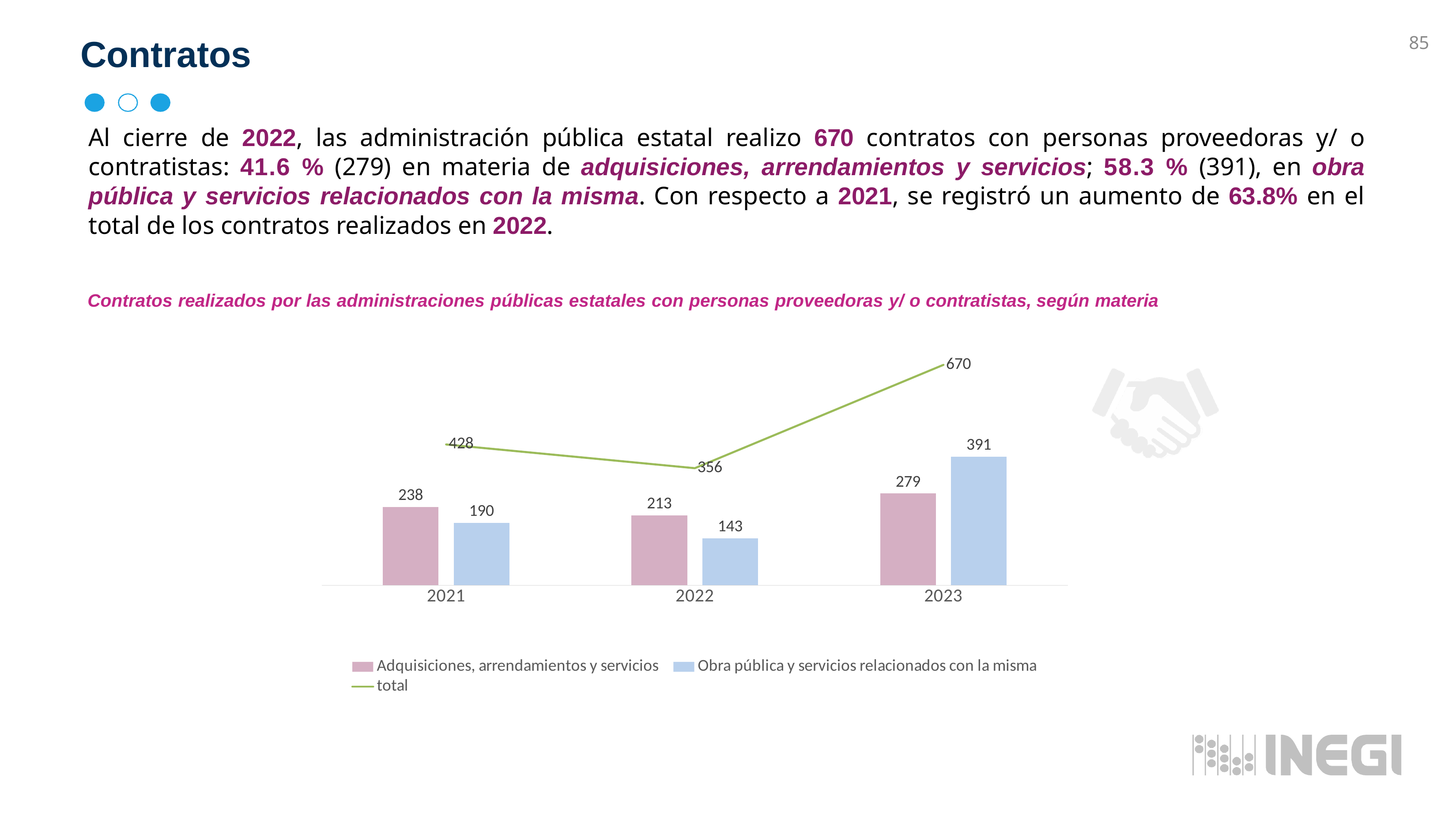
Does the total rise or fall from 2021 to 2022? Fall What is the value for Adquisiciones, arrendamientos y servicios in 2021? 238 How many years are shown on the x axis? 3 What is the difference between the total for 2023 and the total for 2022? 314 Which series is drawn as a line? total How many series does the legend list? 3 What is the value for Obra pública y servicios relacionados con la misma in 2022? 143 In which year is the total highest? 2023 What is the total value shown for 2023? 670 In which year is the value for Obra pública y servicios relacionados con la misma lowest? 2022 What kind of chart is this? Combined bar and line chart Which is larger in 2023: Adquisiciones, arrendamientos y servicios or Obra pública y servicios relacionados con la misma? Obra pública y servicios relacionados con la misma